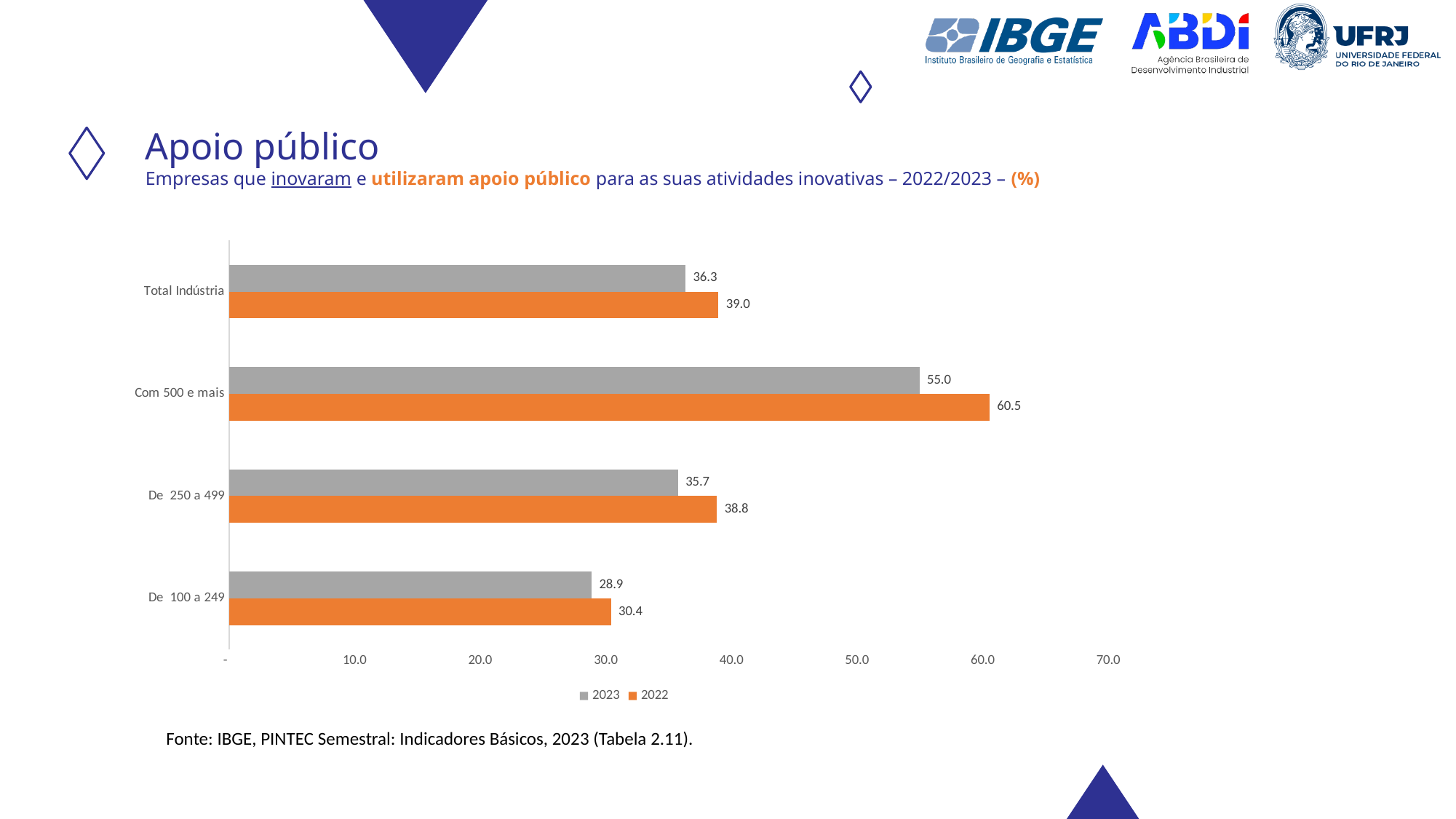
Is the 2023 value for Com 500 e mais greater or less than 50.0? greater What is the 2023 value for De 250 a 499? 35.7 How many series does the legend list? 2 What is the difference between the 2022 and 2023 values for Com 500 e mais? 5.5 What kind of chart is shown on the slide? Bar chart What is the 2022 value for De 100 a 249? 30.4 Which category has the highest 2022 value? Com 500 e mais What is the 2023 value for Total Indústria? 36.3 How many categories are shown on the chart? 4 Which is larger for Total Indústria, the 2022 value or the 2023 value? 2022 Which category has the lowest 2023 value? De 100 a 249 What is the 2022 value for Com 500 e mais? 60.5